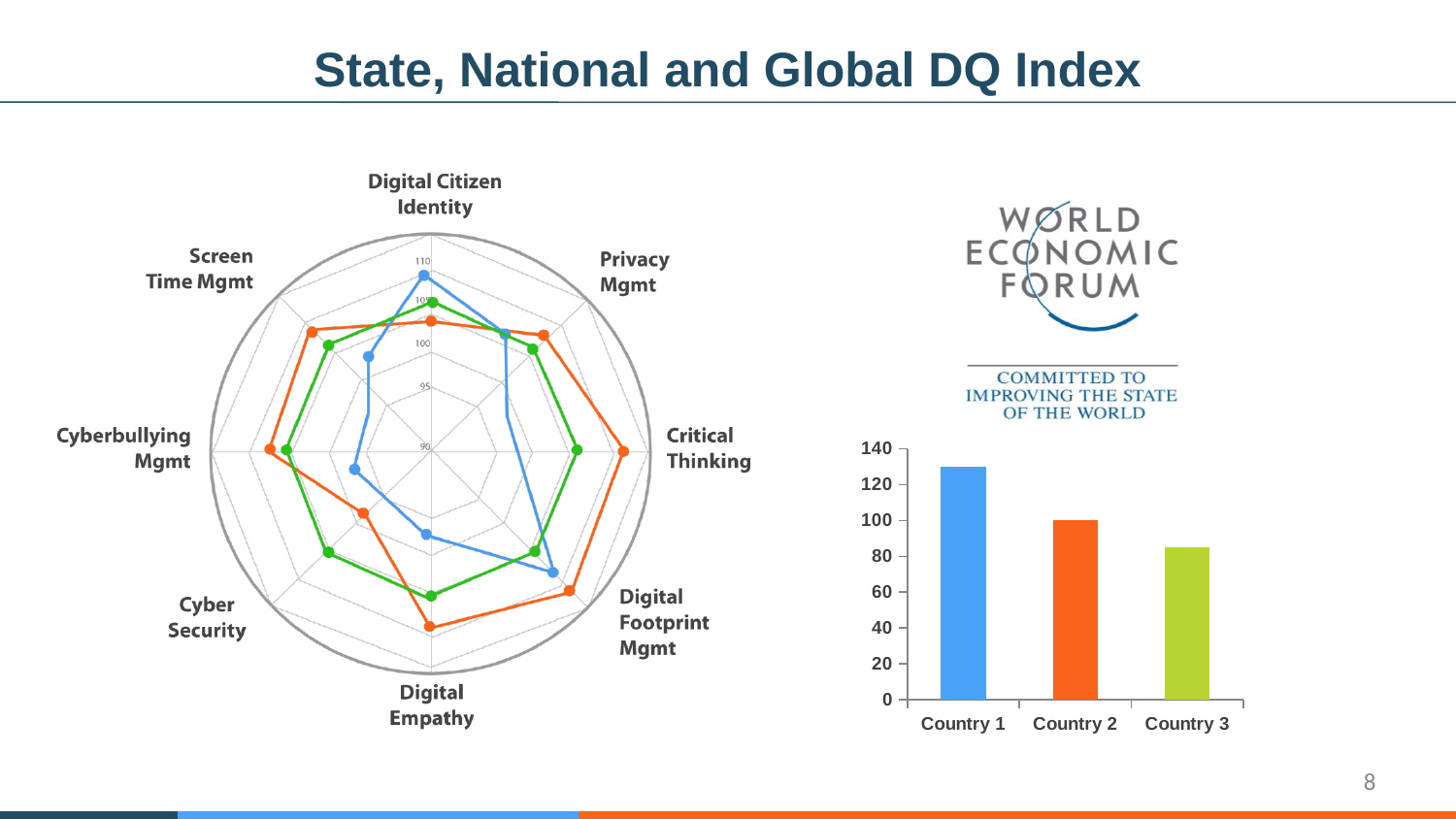
In the bar chart on the right, which is larger, the value for Country 1 or Country 2? Country 1 What kind of chart is the chart on the right of the slide? bar chart In the bar chart on the right, is the value for Country 3 greater or less than 80? greater In the bar chart on the right, which country has the lowest value? Country 3 In the bar chart on the right, how many countries are shown? 3 In the radar chart on the left, which category label appears at the top of the chart? Digital Citizen Identity In the bar chart on the right, is the value for Country 1 greater or less than 120? greater In the bar chart on the right, what is the value for Country 2? 100 What kind of chart is the chart on the left of the slide? radar chart In the radar chart on the left, how many categories are plotted around the chart? 8 In the bar chart on the right, is the value for Country 3 greater or less than 100? less In the bar chart on the right, which country has the highest value? Country 1